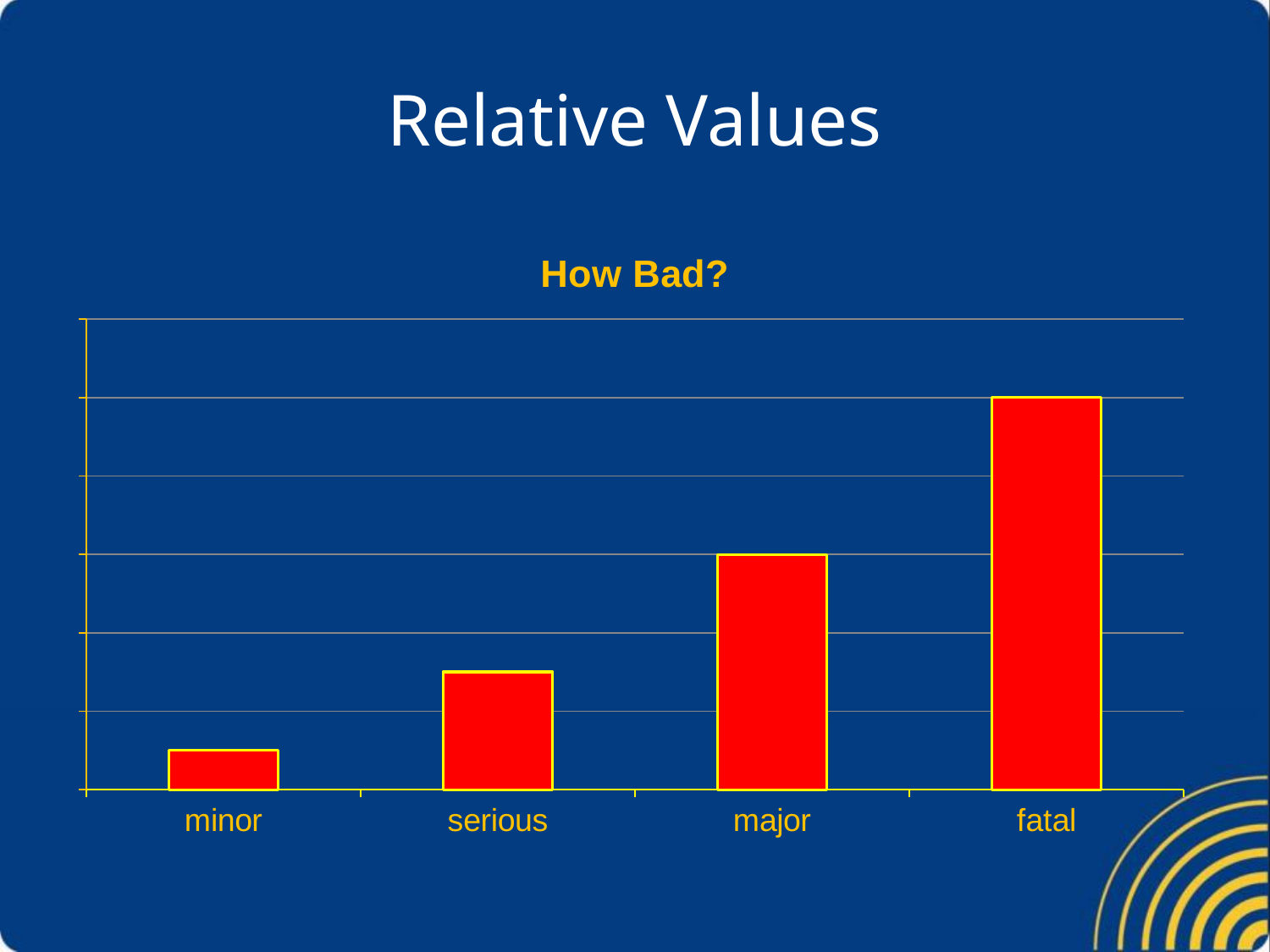
Which category has the highest bar in the chart? fatal Which is larger, the bar for serious or the bar for major? major Do the bar values rise or fall from left to right across the x axis? rise What colour are the bars in the chart? red What is the title of the chart? How Bad? Which category has the lowest bar in the chart? minor How many categories are shown on the x axis of the chart? 4 Which category is plotted immediately to the right of serious? major What kind of chart is shown on the slide? bar chart Which is larger, the bar for minor or the bar for serious? serious